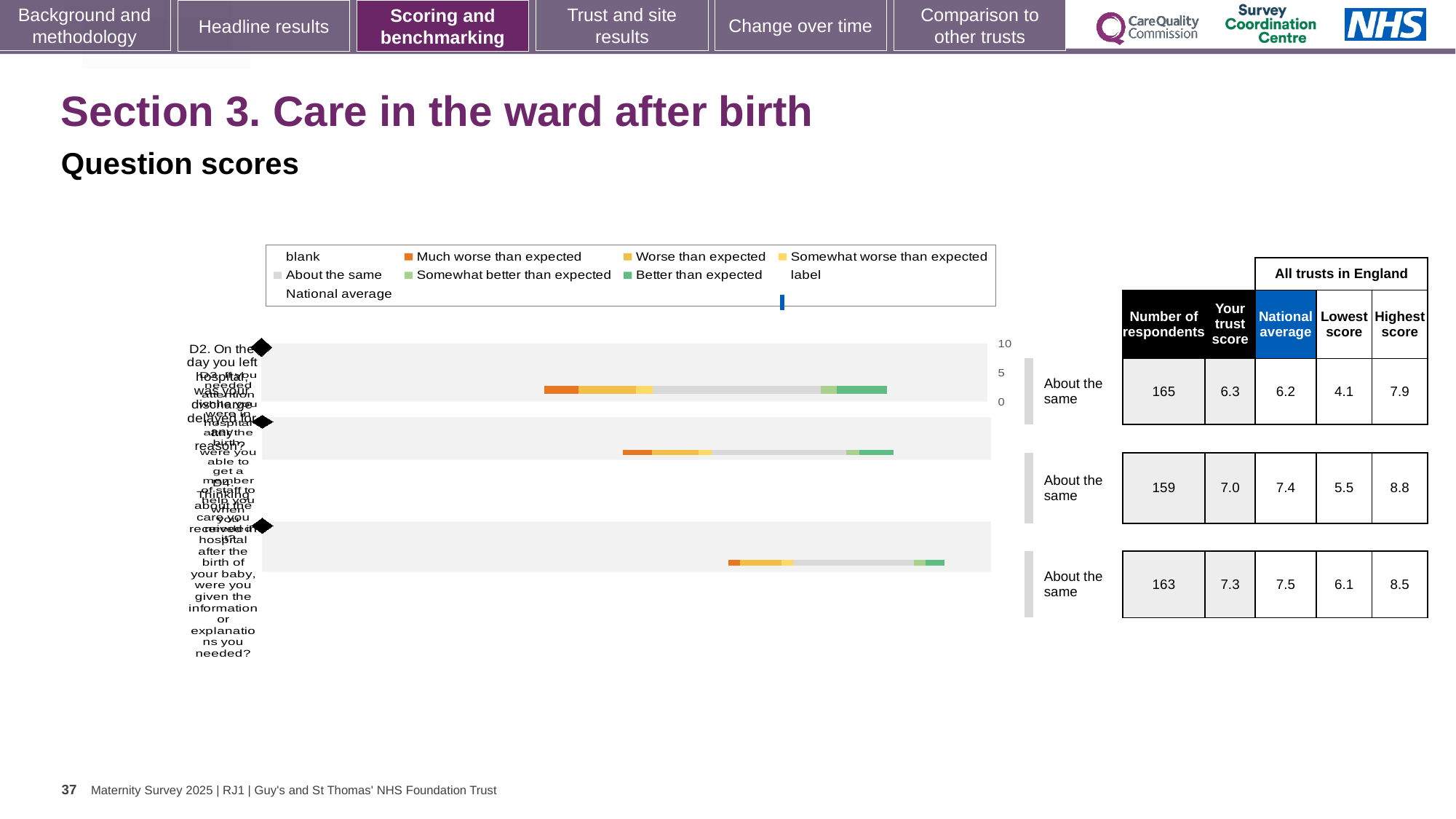
For the second row, what is the difference between the national average and 'Your trust score'? 0.4 What colour does the legend use for 'Better than expected'? green What colour does the legend use for 'Much worse than expected'? orange For the top row, which is larger: 'Your trust score' or the national average? Your trust score What kind of chart is used to show the question scores on this slide? bar chart In the table beside the chart, what is the highest score for the third row? 8.5 What is the highest value shown on the chart's score axis? 10 How many question bars are plotted in the chart? 3 In the table beside the chart, what is the national average for the second row? 7.4 In the table beside the chart, what is the number of respondents for the top row? 165 In the table beside the chart, what is 'Your trust score' for the top row? 6.3 Which row in the table has the highest 'Your trust score'? the third row (7.3)